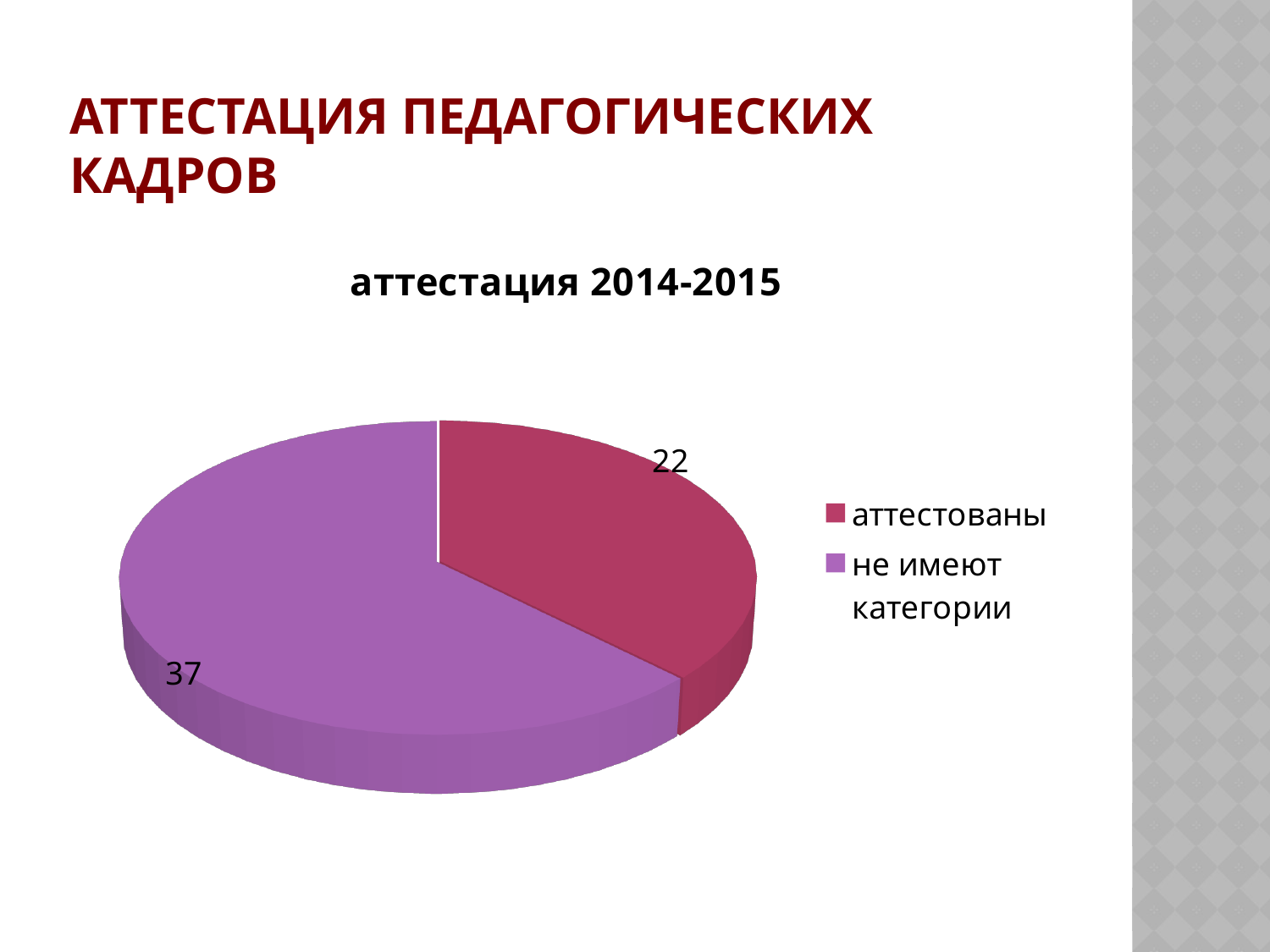
What is the title of the chart? аттестация 2014-2015 Which category has the smallest slice in the pie chart? аттестованы Which category has the largest slice in the pie chart? не имеют категории What is the total of all slices in the pie chart? 59 How many slices does the pie chart have? 2 What is the difference between the values for не имеют категории and аттестованы? 15 How many entries does the legend list? 2 Which is larger: the value for аттестованы or the value for не имеют категории? не имеют категории What is the value for аттестованы in the pie chart? 22 What colour is the slice for аттестованы? red What kind of chart is shown on the slide? pie chart What is the value for не имеют категории in the pie chart? 37